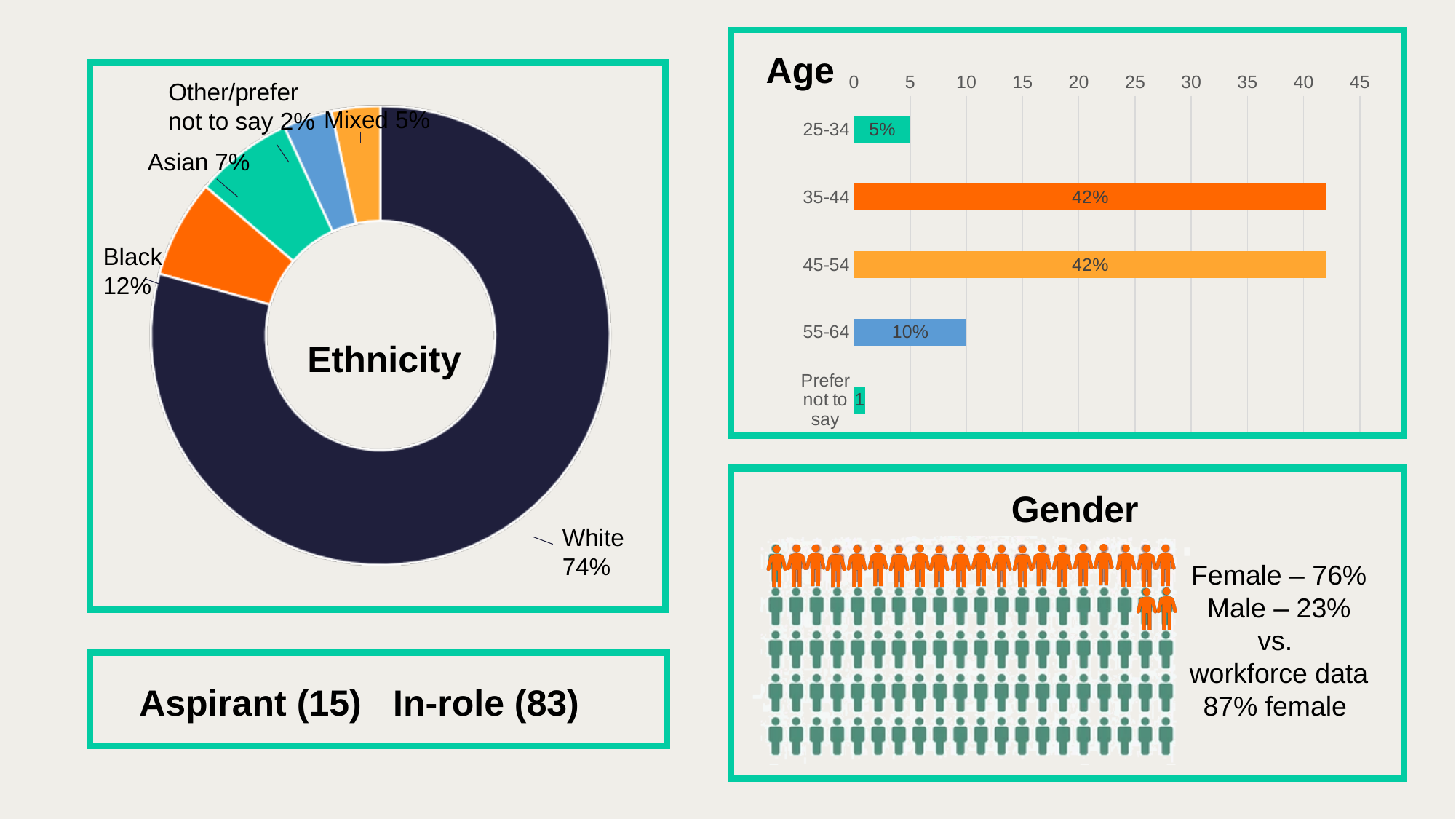
In the Ethnicity chart, which category has the largest share? White In the Ethnicity chart, what percentage is shown for White? 74% What kind of chart is the Ethnicity chart? Pie chart In the Ethnicity chart, what is the difference between the Black and Asian percentages? 5% In the Ethnicity chart, what percentage is shown for Black? 12% In the Age chart, which category has the lowest value? Prefer not to say In the Age chart, what is the value for 25-34? 5% In the Ethnicity chart, which category has the smallest share? Other/prefer not to say In the Age chart, what is the value for 55-64? 10% In the Age chart, which is larger, the value for 55-64 or the value for 25-34? 55-64 What kind of chart is the Age chart? Bar chart How many categories are shown in the Ethnicity chart? 5